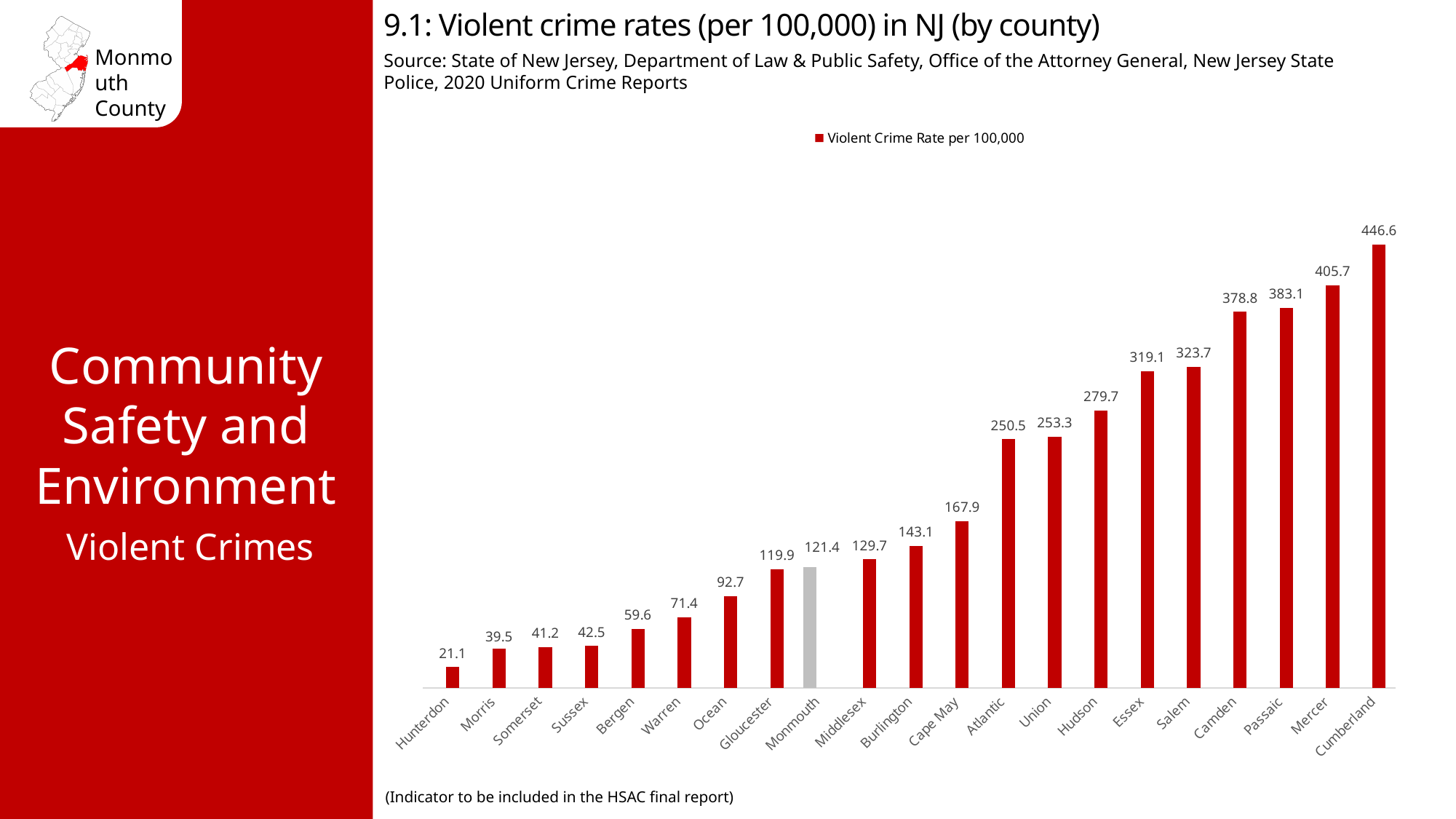
What is the violent crime rate per 100,000 for Hudson? 279.7 How many counties are shown on the chart? 21 Which county has the lowest violent crime rate? Hunterdon How many series does the legend list? 1 Which county has the highest violent crime rate? Cumberland What is the violent crime rate per 100,000 for Cape May? 167.9 Do the violent crime rates rise or fall from left to right along the x axis? Rise What is the difference between the violent crime rates of Cumberland and Hunterdon? 425.5 What is the difference between the violent crime rates of Mercer and Monmouth? 284.3 Which county has a higher violent crime rate, Atlantic or Essex? Essex What kind of chart is shown on the slide? Bar chart What is the violent crime rate per 100,000 for Monmouth County? 121.4